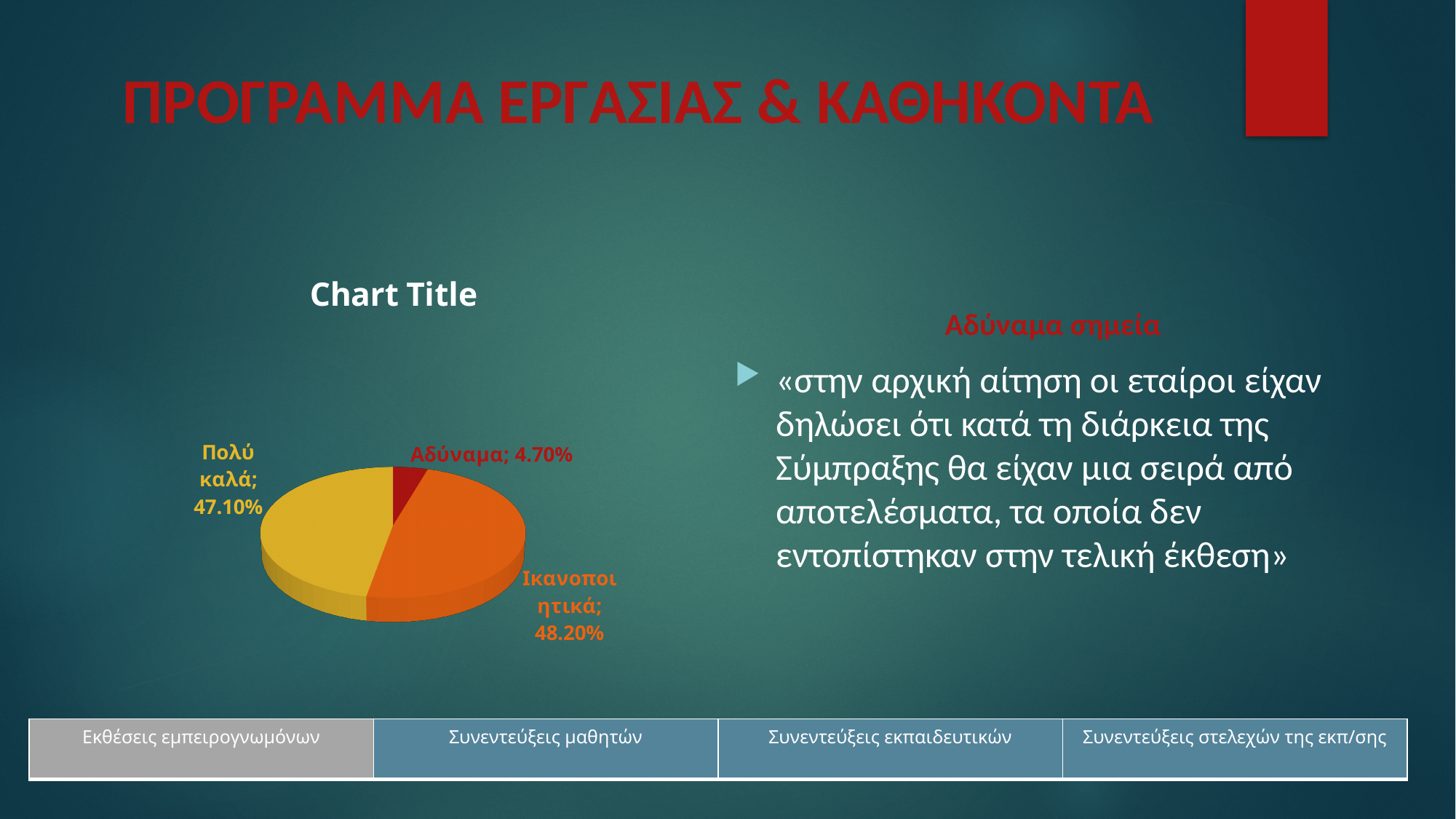
What share of the pie is labelled Ικανοποιητικά? 48.20% How many slices does the pie chart have? 3 What kind of chart is shown on the slide? pie chart What share of the pie is labelled Πολύ καλά? 47.10% What is the difference between the Πολύ καλά and Αδύναμα shares? 42.40% What is the title of the chart? Chart Title What colour is the Αδύναμα slice of the pie chart? dark red What is the difference between the Ικανοποιητικά and Πολύ καλά shares? 1.10% What share of the pie is labelled Αδύναμα? 4.70% Which slice of the pie chart is the smallest? Αδύναμα Which slice of the pie chart is the largest? Ικανοποιητικά Which is larger, the Πολύ καλά slice or the Αδύναμα slice? Πολύ καλά